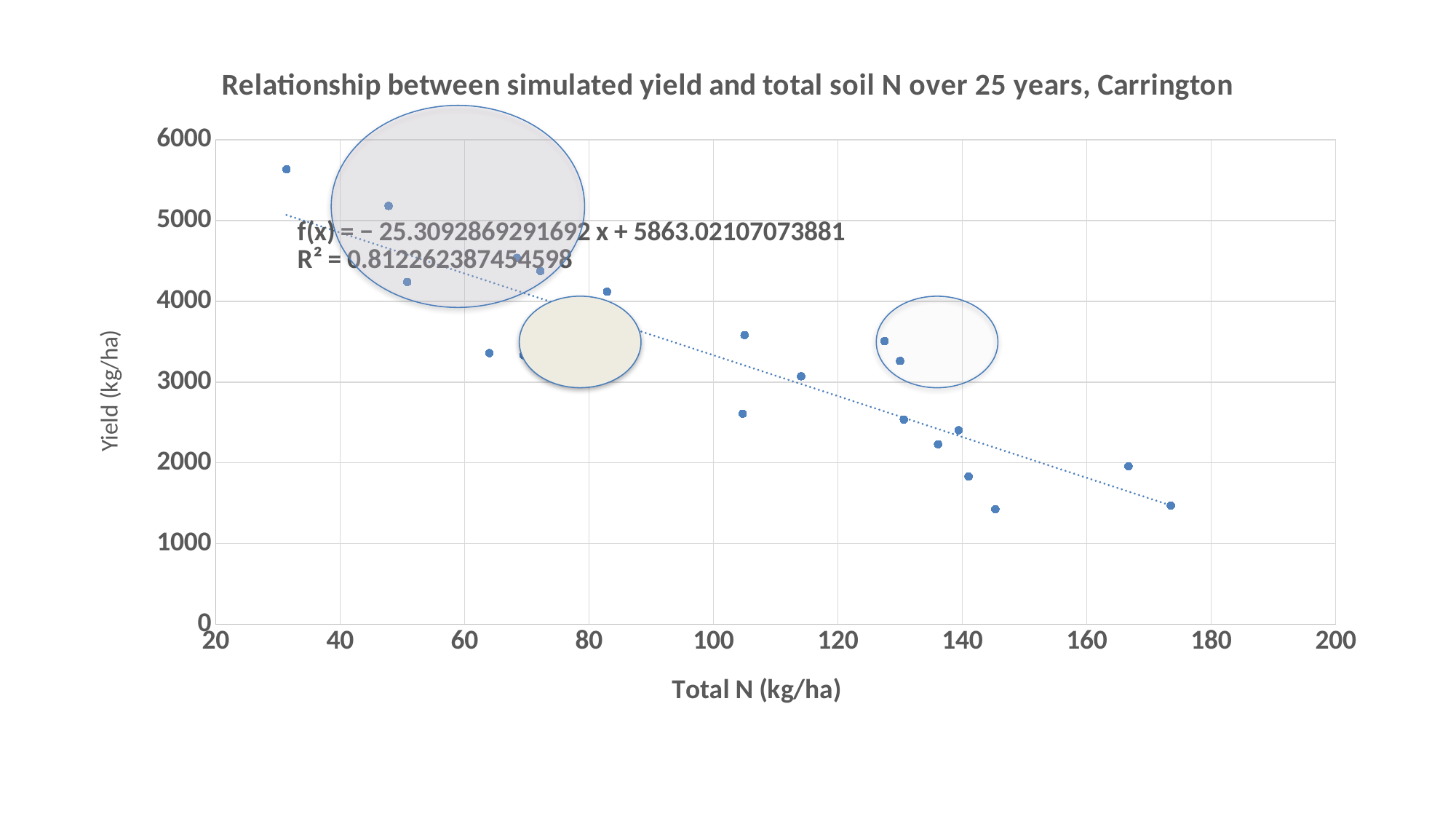
What is the slope of the fitted line f(x) printed on the chart? − 25.3092869291692 What is the highest value shown on the y axis? 6000 As Total N increases along the x axis, does simulated yield generally rise or fall? Fall What R² value is printed on the chart for the trendline? 0.812262387454598 What is the title of the chart? Relationship between simulated yield and total soil N over 25 years, Carrington What is the highest value shown on the x axis? 200 What is the label of the x axis? Total N (kg/ha) Is the yield of the rightmost point (highest Total N) greater or less than 2000? less What is the intercept of the fitted line f(x) printed on the chart? 5863.02107073881 Is the yield of the leftmost point (lowest Total N) greater or less than 5000? greater What kind of chart is shown on the slide? Scatter chart Which has the higher yield, the leftmost point or the rightmost point? The leftmost point